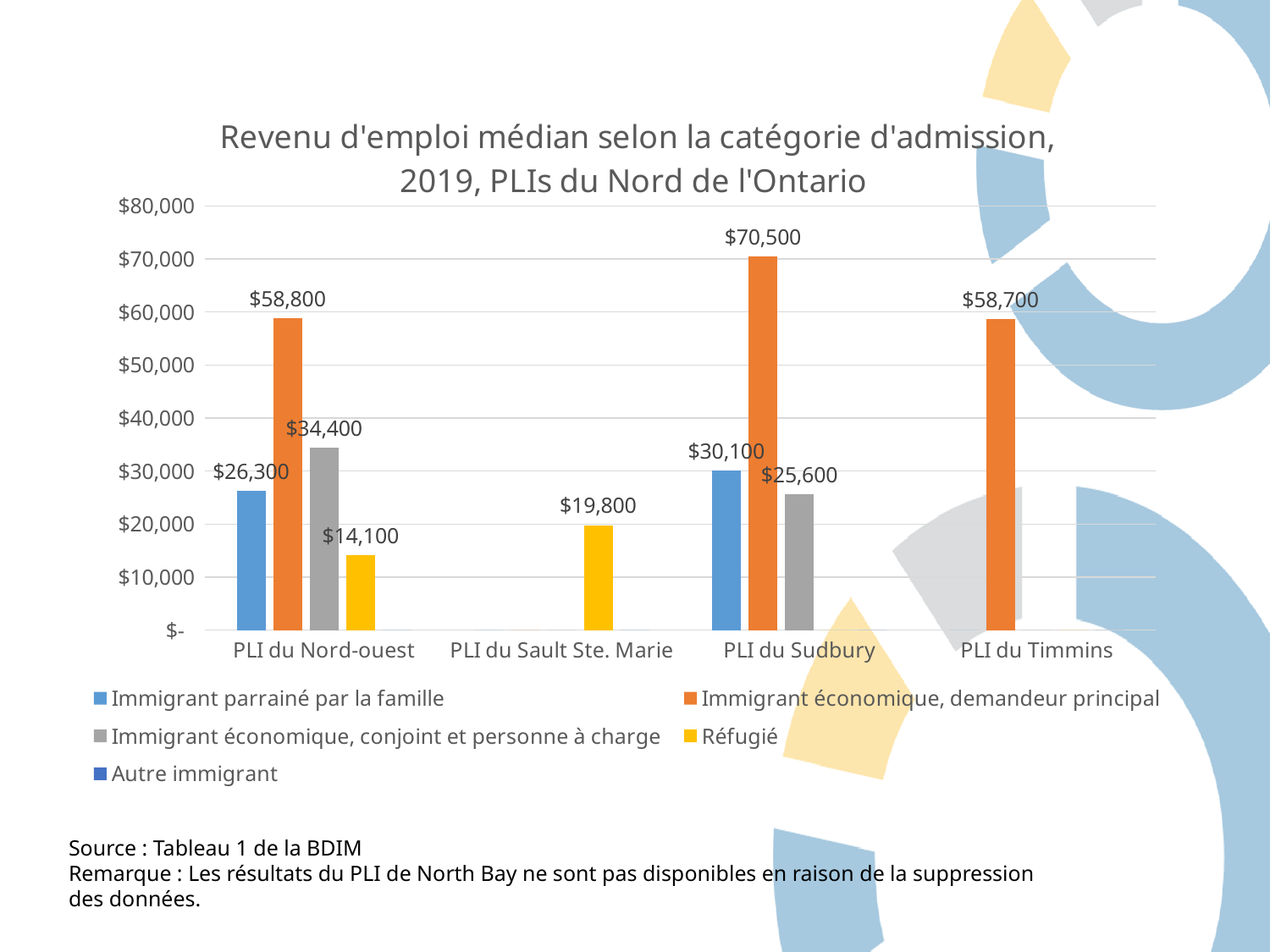
Which PLI has the highest value for 'Immigrant économique, demandeur principal'? PLI du Sudbury What is the value for 'Réfugié' in PLI du Sault Ste. Marie? $19,800 Which category has the lowest value in PLI du Nord-ouest? Réfugié What is the median employment income for 'Immigrant économique, demandeur principal' in PLI du Sudbury? $70,500 What is the difference between the 'Immigrant économique, demandeur principal' values for PLI du Sudbury and PLI du Nord-ouest? $11,700 How many PLIs are shown on the x axis? 4 What is the value for 'Immigrant économique, demandeur principal' in PLI du Timmins? $58,700 Is the 'Réfugié' value for PLI du Nord-ouest greater or less than $20,000? less How many series does the legend list? 5 Which is larger: the 'Immigrant économique, conjoint et personne à charge' value for PLI du Nord-ouest or for PLI du Sudbury? PLI du Nord-ouest What kind of chart is shown on the slide? Bar chart What is the value for 'Immigrant parrainé par la famille' in PLI du Nord-ouest? $26,300